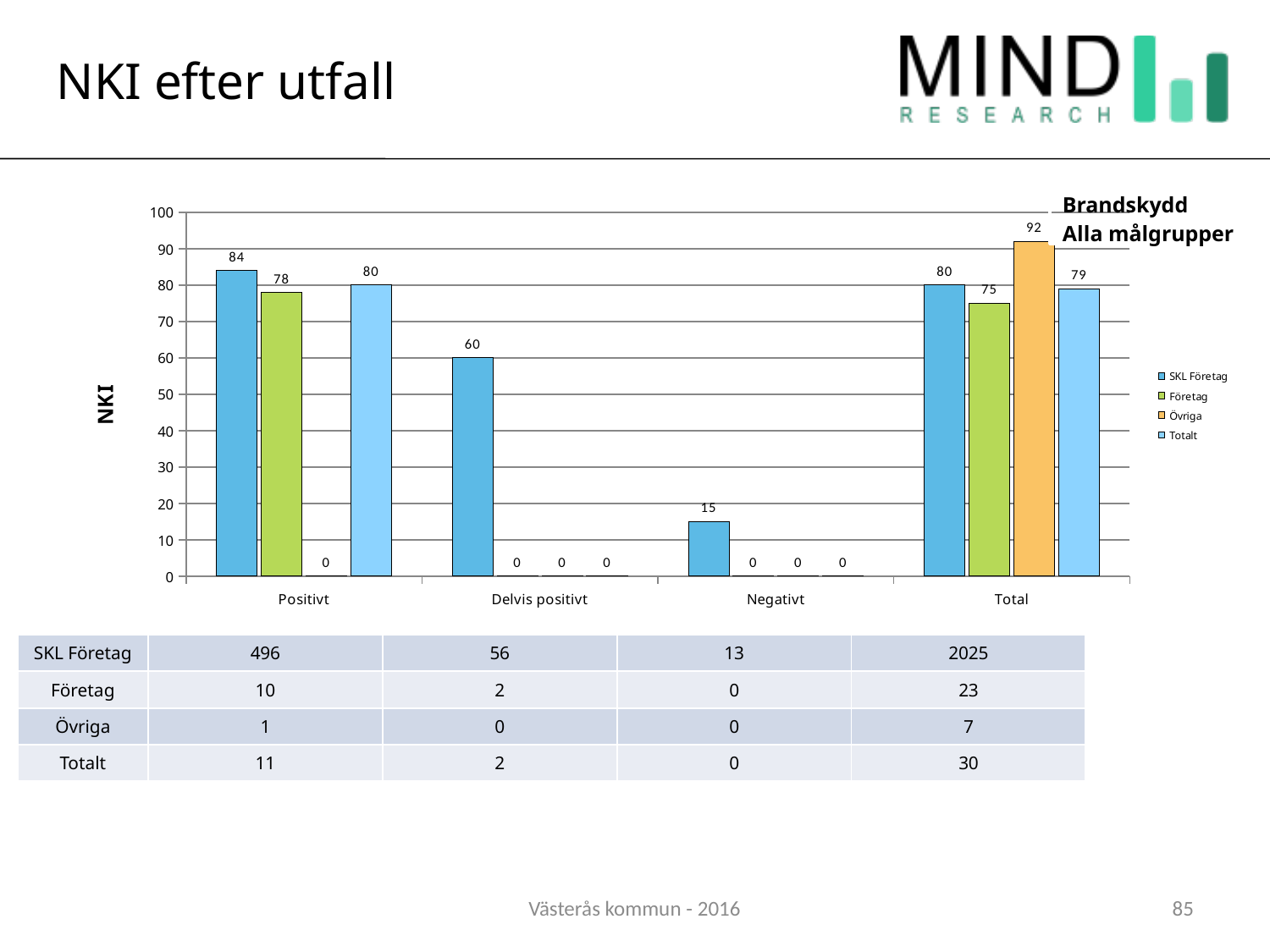
What kind of chart is shown on the slide? Bar chart How many series does the legend list? 4 What is the value for SKL Företag in the Positivt category? 84 Which category has the lowest value for SKL Företag? Negativt What is the value for Företag in the Total category? 75 What is the value for SKL Företag in the Delvis positivt category? 60 What is the difference between the SKL Företag and Företag values in the Positivt category? 6 How many categories are shown on the x axis? 4 What is the value for SKL Företag in the Negativt category? 15 Which is larger in the Total category: SKL Företag or Totalt? SKL Företag What is the value for Övriga in the Total category? 92 Which series has the highest value in the Total category? Övriga